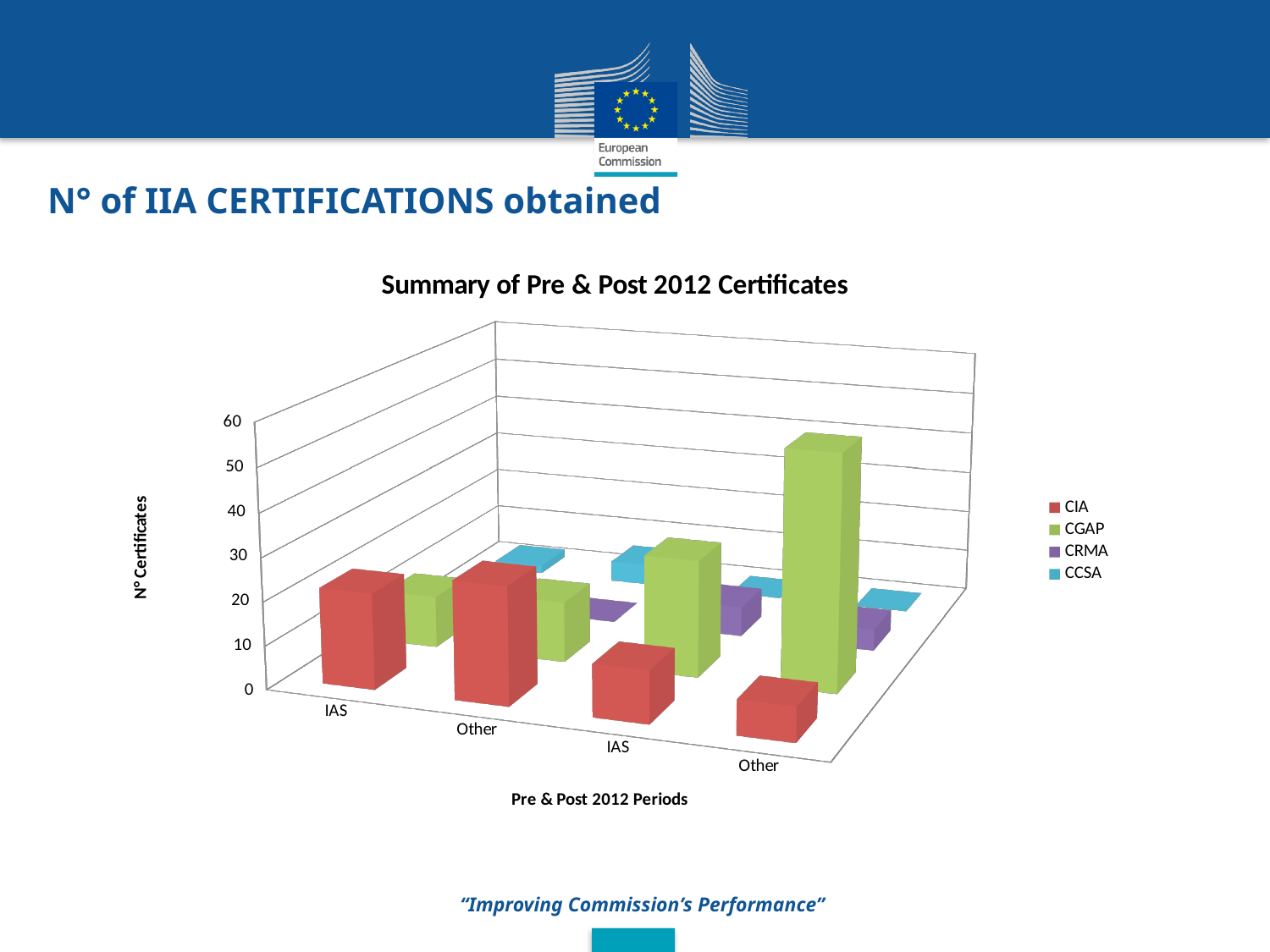
Is the CIA value for the rightmost Other category greater or less than 20? less How many series does the legend list? 4 Which is larger: the CGAP value for the leftmost IAS category or the CGAP value for the rightmost Other category? the rightmost Other category What kind of chart is shown on the slide? bar chart What is the title of the chart? Summary of Pre & Post 2012 Certificates Which series is shown in green in the legend? CGAP Which series has the lowest bar for the rightmost Other category? CCSA Which series has the tallest bar in the chart? CGAP Which is larger: the CIA value for the leftmost IAS category or the CIA value for the rightmost Other category? the leftmost IAS category Is the CGAP value for the rightmost Other category greater or less than 40? greater How many categories are shown along the x axis? 4